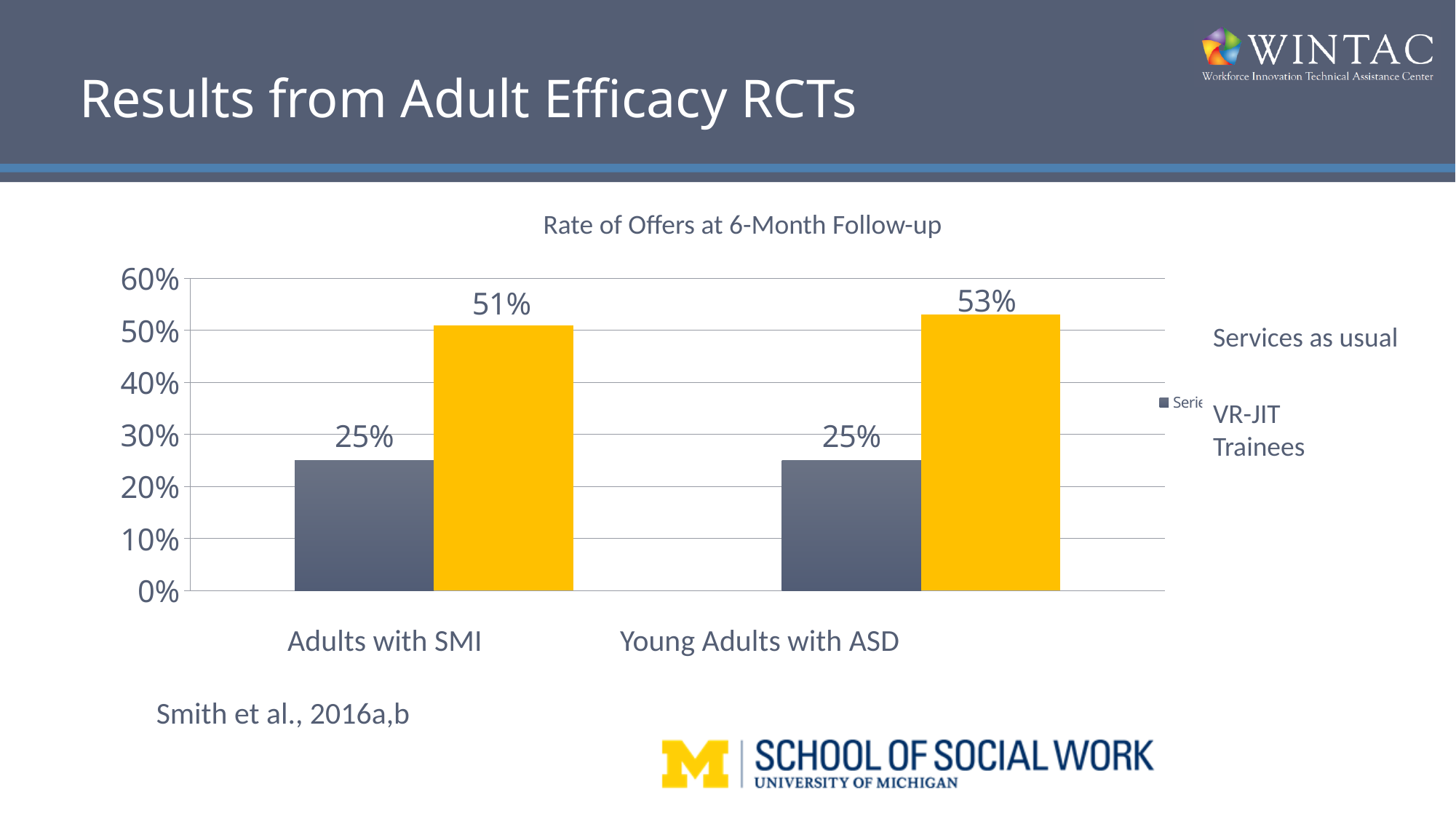
What is the rate of offers for VR-JIT Trainees among Young Adults with ASD? 53% Is the VR-JIT Trainees value for Adults with SMI greater or less than 40%? greater What is the rate of offers for Services as usual among Young Adults with ASD? 25% What is the difference between the VR-JIT Trainees and Services as usual rates for Young Adults with ASD? 28% Which group has the higher VR-JIT Trainees rate of offers, Adults with SMI or Young Adults with ASD? Young Adults with ASD Which bar shows the highest rate of offers? VR-JIT Trainees, Young Adults with ASD How many participant groups are shown on the x axis? 2 What is the difference between the VR-JIT Trainees and Services as usual rates for Adults with SMI? 26% What is the title of the chart? Rate of Offers at 6-Month Follow-up How many data series are plotted in the chart? 2 What type of chart is shown on the slide? bar chart What is the rate of offers for VR-JIT Trainees among Adults with SMI? 51%